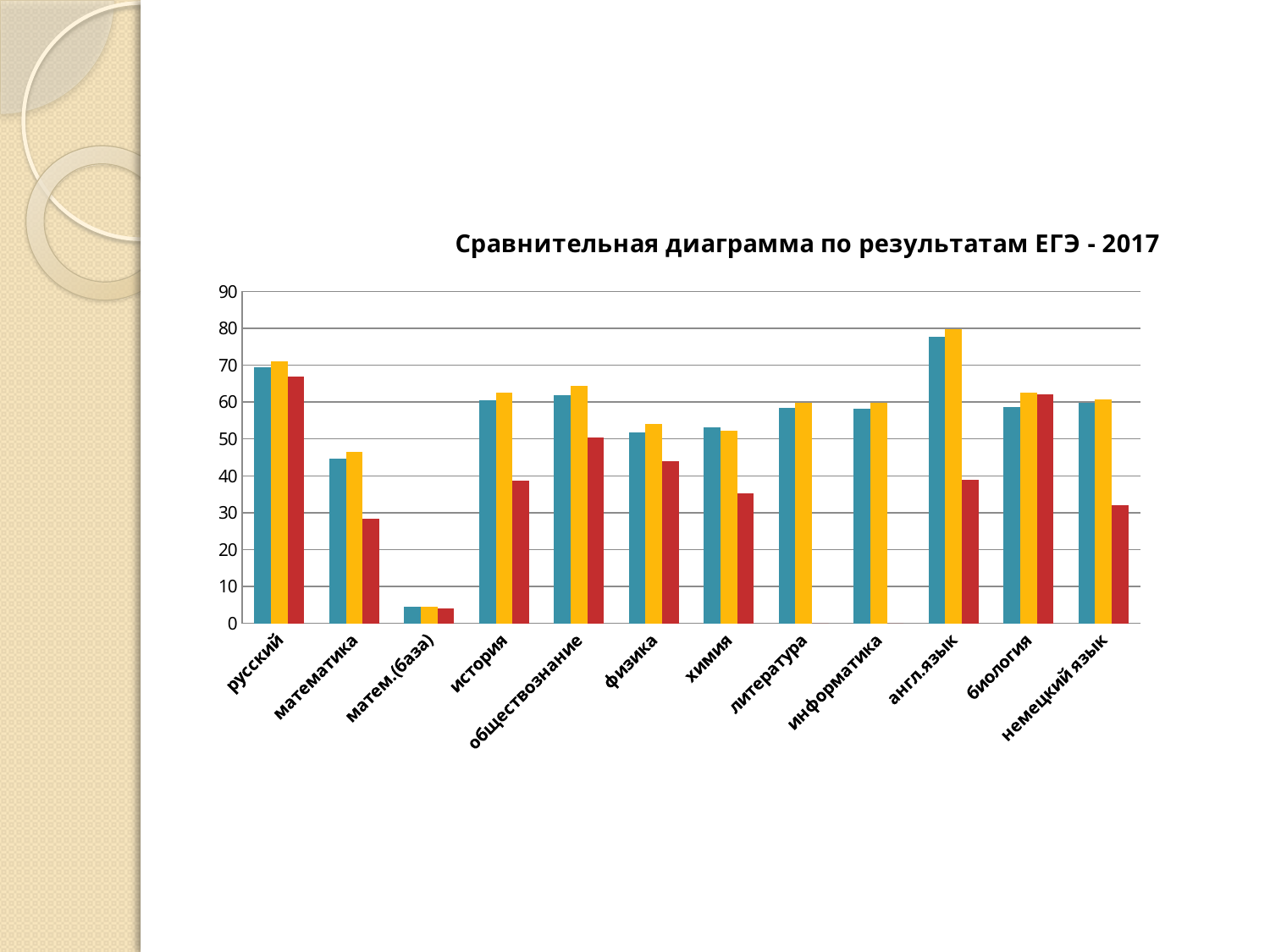
Which category has the lowest bars overall? матем.(база) Which categories have only two bars instead of three? литература and информатика Is the value of the red bar for математика greater or less than 40? less What is the title of the chart? Сравнительная диаграмма по результатам ЕГЭ - 2017 Is the value of the red bar for немецкий язык greater or less than 40? less Which category has the tallest bar in the chart? англ.язык Is the value of the first (teal) bar for русский greater or less than 60? greater What kind of chart is shown on the slide? bar chart Which is larger: the red bar for русский or the red bar for химия? русский How many subject categories are shown on the x axis? 12